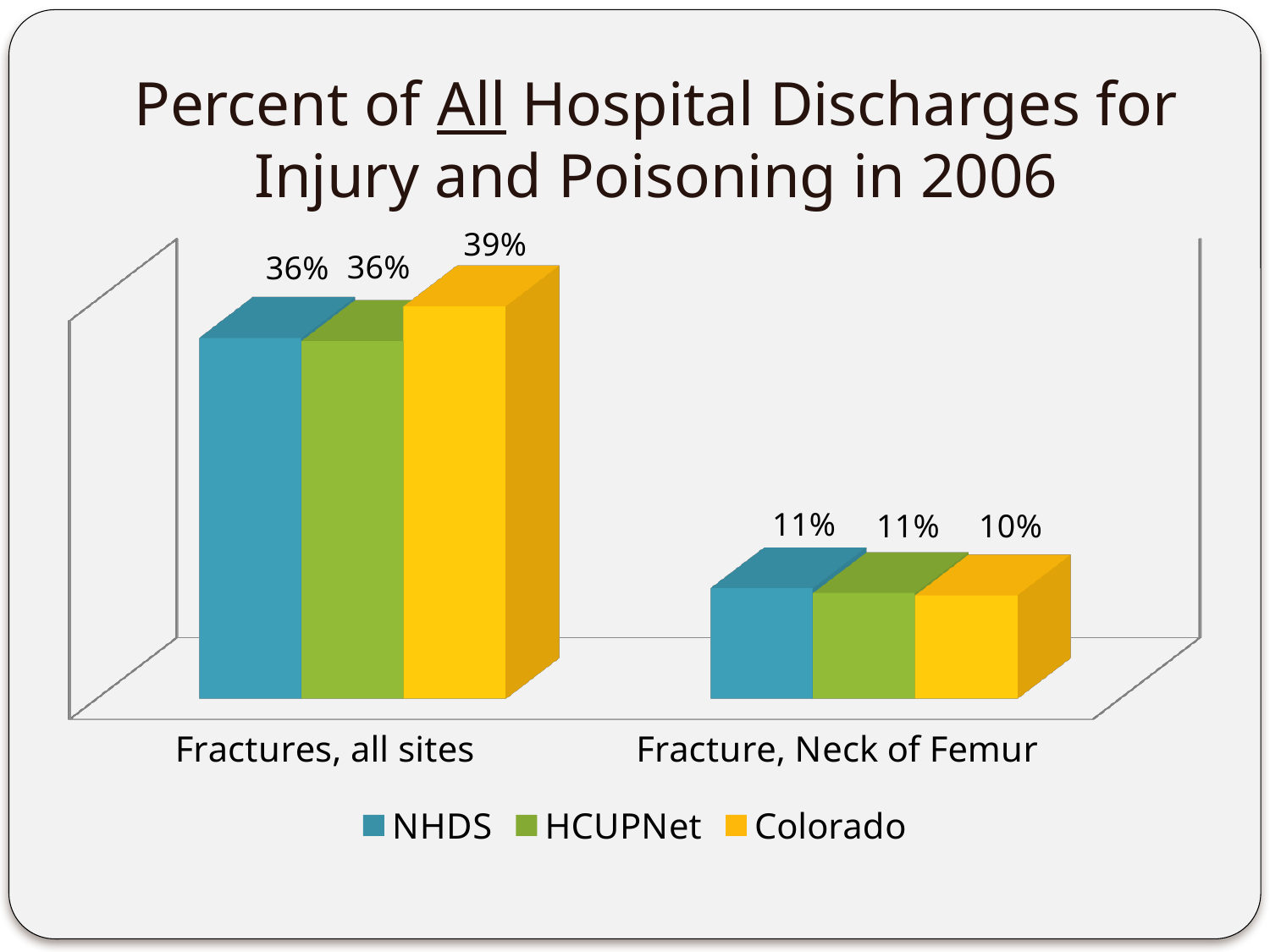
Which is larger: the Colorado value for Fractures, all sites or the Colorado value for Fracture, Neck of Femur? Fractures, all sites What is the difference between the NHDS values for Fractures, all sites and Fracture, Neck of Femur? 25% What is the value for Colorado in the Fracture, Neck of Femur category? 10% How many series does the legend list? 3 How many categories are shown on the x axis? 2 What is the value for Colorado in the Fractures, all sites category? 39% What is the value for NHDS in the Fracture, Neck of Femur category? 11% What is the difference between the Colorado and NHDS values for Fractures, all sites? 3% Which series has the lowest value in the Fracture, Neck of Femur category? Colorado Which series has the highest value in the Fractures, all sites category? Colorado What kind of chart is shown on the slide? Bar chart What is the value for HCUPNet in the Fractures, all sites category? 36%